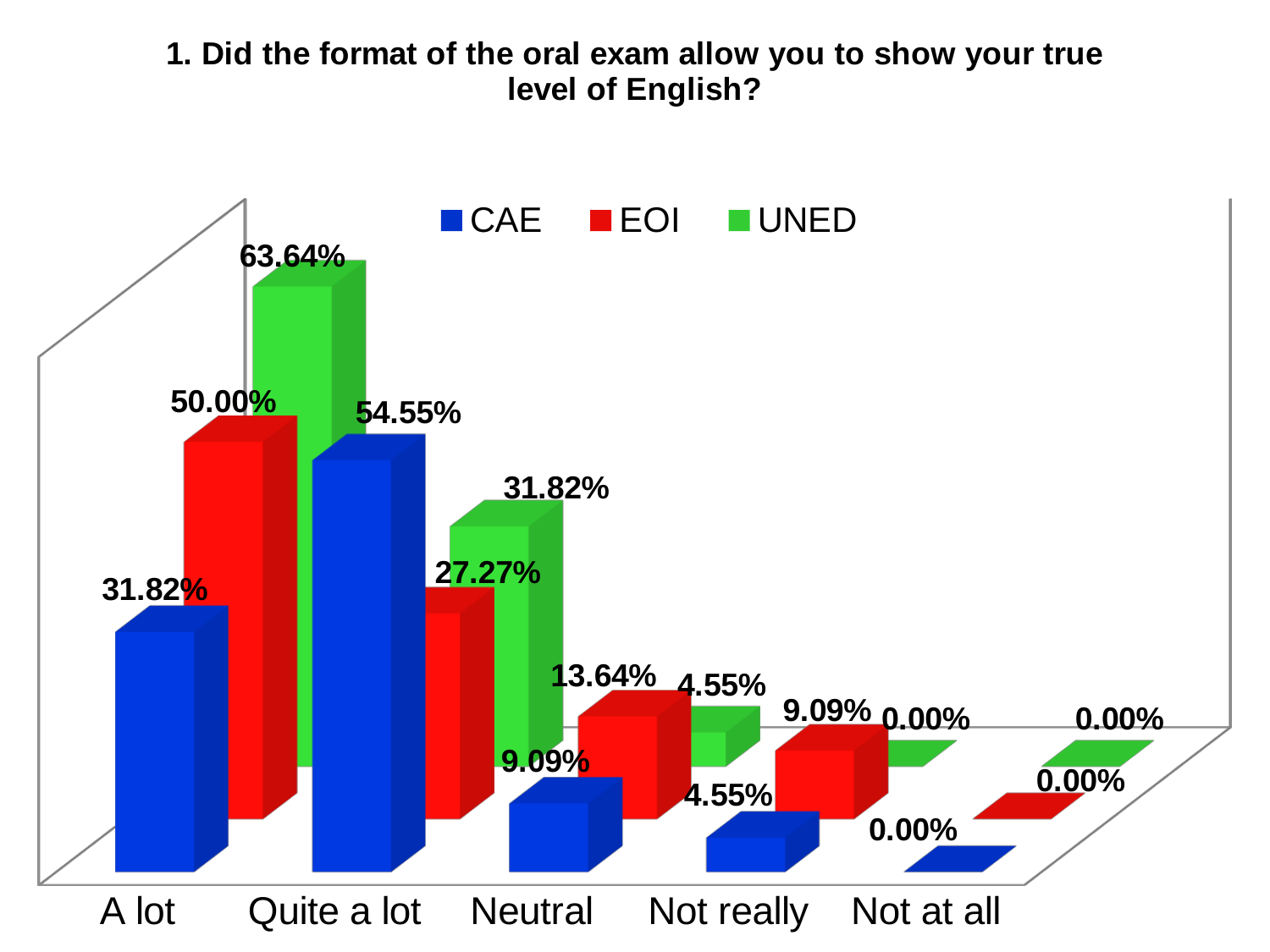
How many response categories are shown on the x axis? 5 What is the CAE value for "Quite a lot"? 54.55% What percentage of UNED respondents answered "A lot"? 63.64% How many series does the legend list? 3 For "Quite a lot", which is larger: the EOI value or the UNED value? UNED What kind of chart is shown on the slide? Bar chart What is the UNED value for "Not really"? 0.00% Which category has the highest EOI value? A lot Which category has the highest CAE value? Quite a lot What is the difference between the UNED and CAE values for "A lot"? 31.82% Which colour represents EOI in the chart? Red What is the EOI value for "Neutral"? 13.64%